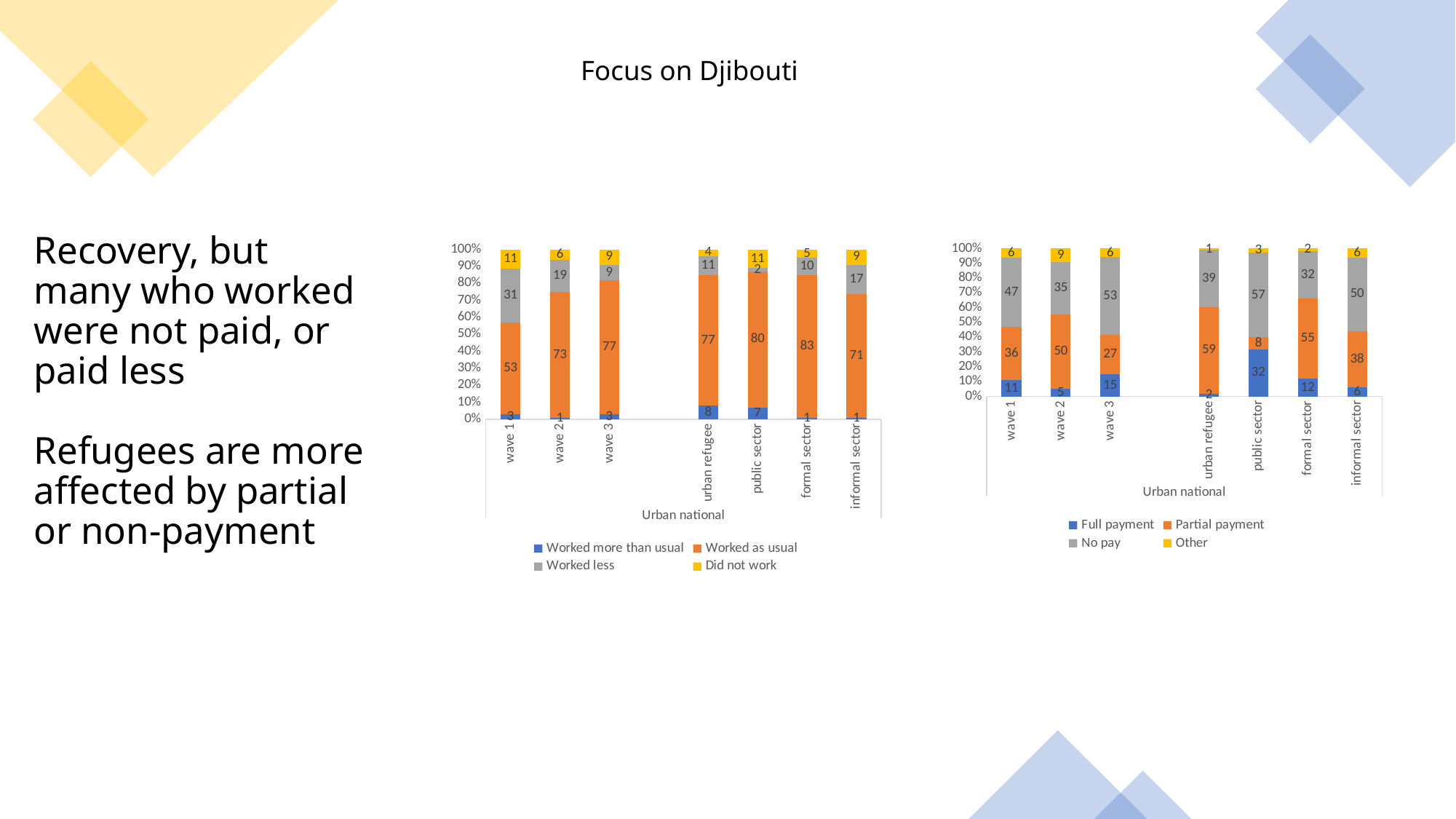
In the right chart, what is the value for 'Partial payment' for urban refugee? 59 In the left chart, what is the value for 'Worked less' for informal sector? 17 In the right chart, which category has the highest 'Full payment' value? public sector In the right chart, which is larger: the 'No pay' value for wave 3 or for wave 2? wave 3 In the right chart, what colour represents 'Other' in the legend? yellow What kind of chart is the right chart? stacked bar chart In the right chart, how many categories are shown on the x axis? 7 In the left chart, what is the difference between the 'Worked as usual' values for wave 3 and wave 1? 24 In the left chart, what is the value for 'Worked as usual' for wave 1? 53 In the right chart, what is the value for 'No pay' for public sector? 57 In the left chart, which category has the highest 'Worked as usual' value? formal sector In the left chart, how many series does the legend list? 4